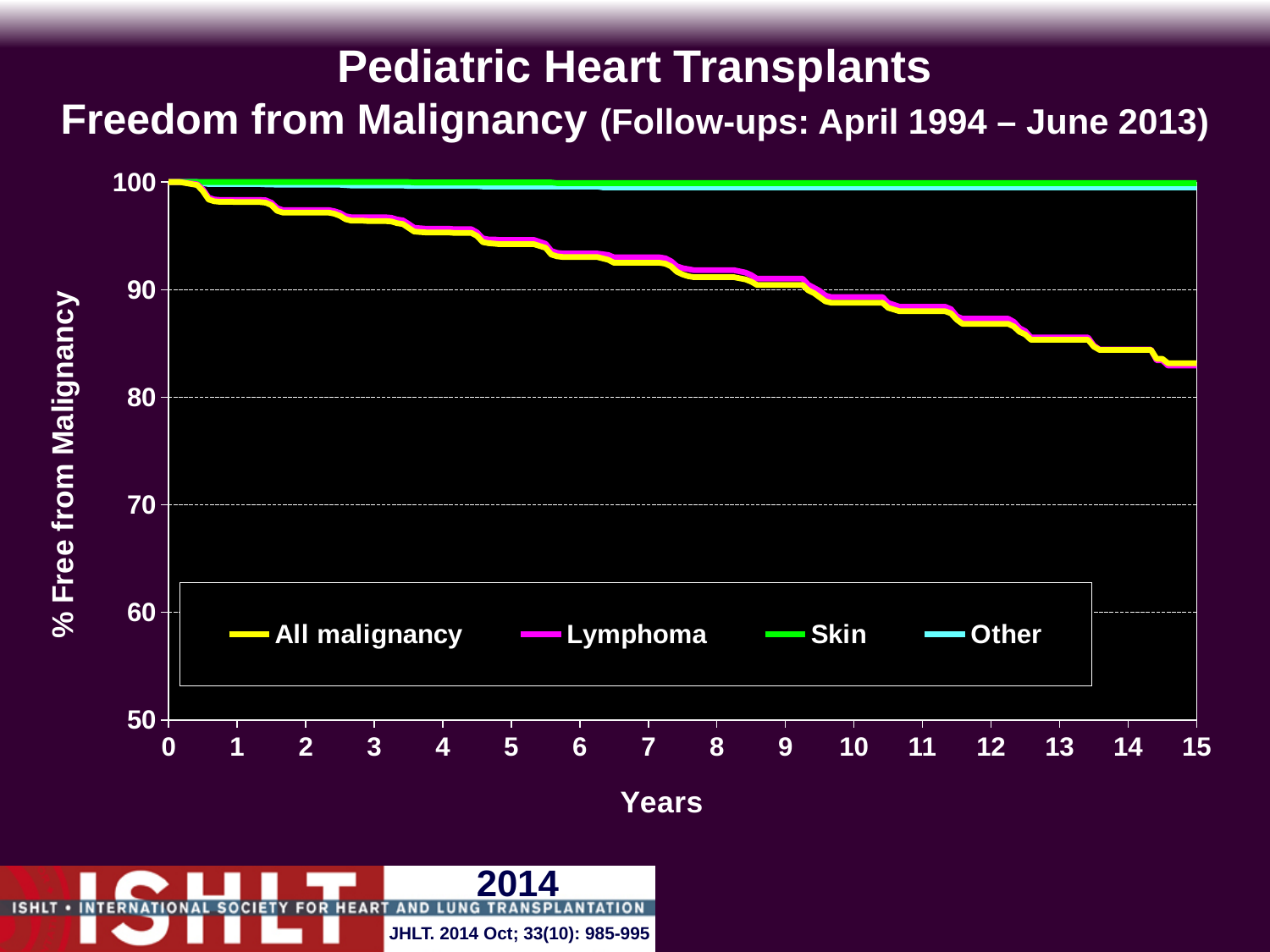
Does the All malignancy line rise or fall as years increase? fall Which series has the lowest value at 15 years? Lymphoma Which series are listed in the legend? All malignancy, Lymphoma, Skin, Other Is the value for Skin at 15 years greater or less than 90? greater At 15 years, which is higher: Skin or All malignancy? Skin What is the label of the y axis? % Free from Malignancy Is the value for All malignancy at 5 years greater or less than 90? greater Is the value for All malignancy at 15 years greater or less than 90? less How many series does the legend list? 4 What kind of chart is shown on the slide? line chart